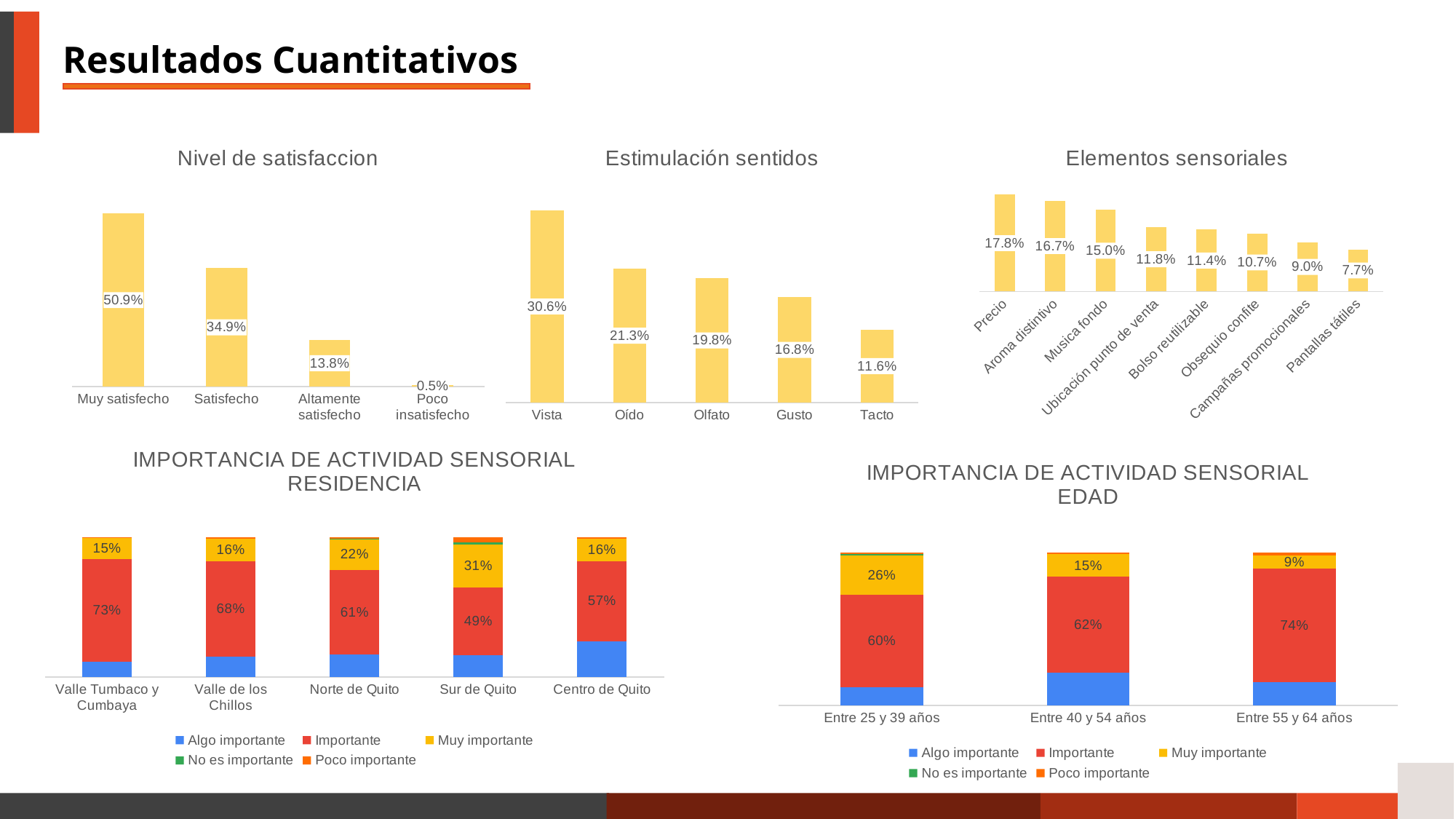
In the 'IMPORTANCIA DE ACTIVIDAD SENSORIAL RESIDENCIA' chart, what is the 'Muy importante' value for Sur de Quito? 31% In the 'IMPORTANCIA DE ACTIVIDAD SENSORIAL EDAD' chart, what is the 'Importante' value for Entre 55 y 64 años? 74% In the 'Estimulación sentidos' chart, what is the difference between Vista and Tacto? 19.0% In the 'Nivel de satisfaccion' chart, what is the value for Satisfecho? 34.9% In the 'Elementos sensoriales' chart, what is the value for Bolso reutilizable? 11.4% In the 'Elementos sensoriales' chart, which element has the lowest value? Pantallas tátiles In the 'Elementos sensoriales' chart, do the values rise or fall from left to right? fall How many series does the legend of the 'IMPORTANCIA DE ACTIVIDAD SENSORIAL EDAD' chart list? 5 In the 'Nivel de satisfaccion' chart, which category has the lowest value? Poco insatisfecho In the 'Estimulación sentidos' chart, how many categories are shown? 5 In the 'IMPORTANCIA DE ACTIVIDAD SENSORIAL RESIDENCIA' chart, which is larger for 'Importante': Valle Tumbaco y Cumbaya or Centro de Quito? Valle Tumbaco y Cumbaya In the 'Estimulación sentidos' chart, which sense has the highest value? Vista